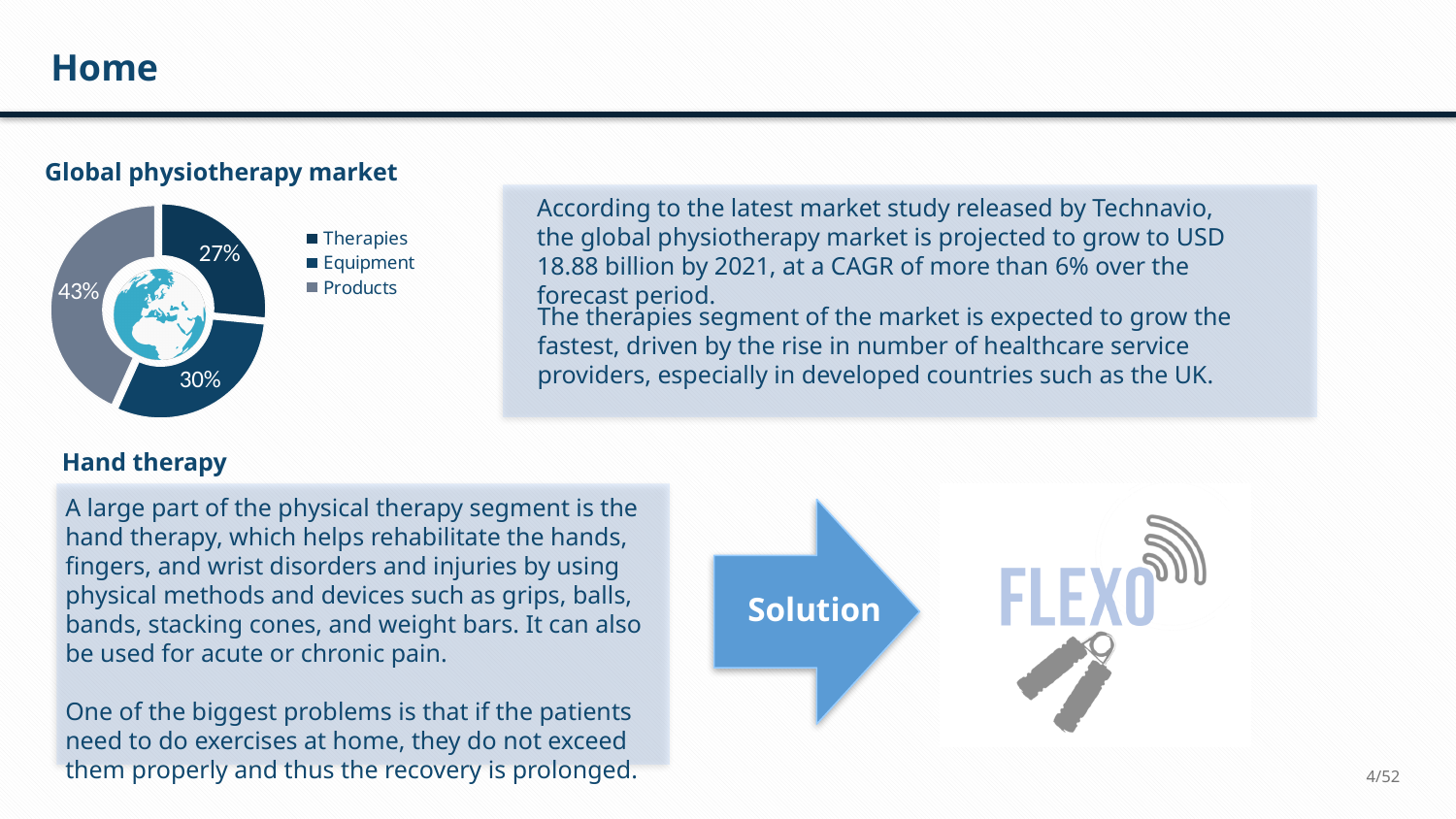
What share of the global physiotherapy market does the Equipment slice represent? 30% How many entries does the legend of the pie chart list? 3 Which slice is larger, Equipment or Therapies? Equipment What is the difference in percentage points between the Products and Therapies slices? 16 Which segment has the largest share in the global physiotherapy market chart? Products What share of the global physiotherapy market does the Therapies slice represent? 27% What share of the global physiotherapy market does the Products slice represent? 43% What is the difference in percentage points between the Equipment and Therapies slices? 3 Which segment has the smallest share in the global physiotherapy market chart? Therapies How many slices does the global physiotherapy market pie chart have? 3 What is the title shown above the pie chart? Global physiotherapy market What kind of chart is shown under the heading 'Global physiotherapy market'? Doughnut chart